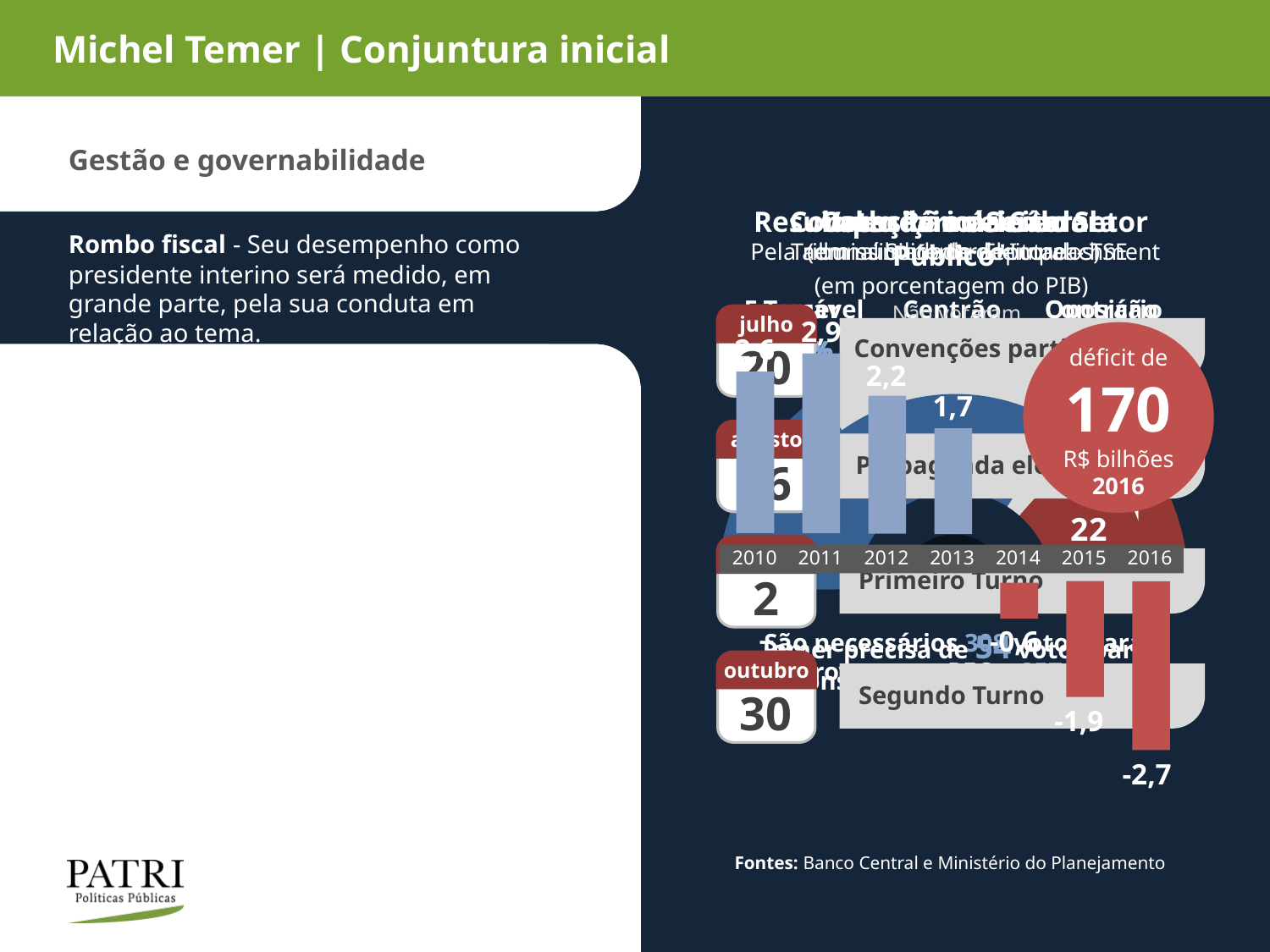
What is the difference between the values for 2012 and 2013 in the bar chart? 0,5 What is the value for 2013 in the bar chart? 1,7 What is the value for 2011 in the bar chart? 2,9 In what unit are the values of the bar chart expressed, according to the subtitle? em porcentagem do PIB What is the value for 2014 in the bar chart? -0,6 What is the value for 2015 in the bar chart? -1,9 What is the value for 2016 in the bar chart? -2,7 What kind of chart is shown on the slide? Bar chart How many years are shown on the x axis of the bar chart? 7 Which year has the larger value in the bar chart, 2012 or 2013? 2012 Which year has the lowest value in the bar chart? 2016 Do the values in the bar chart rise or fall from 2011 to 2016? Fall